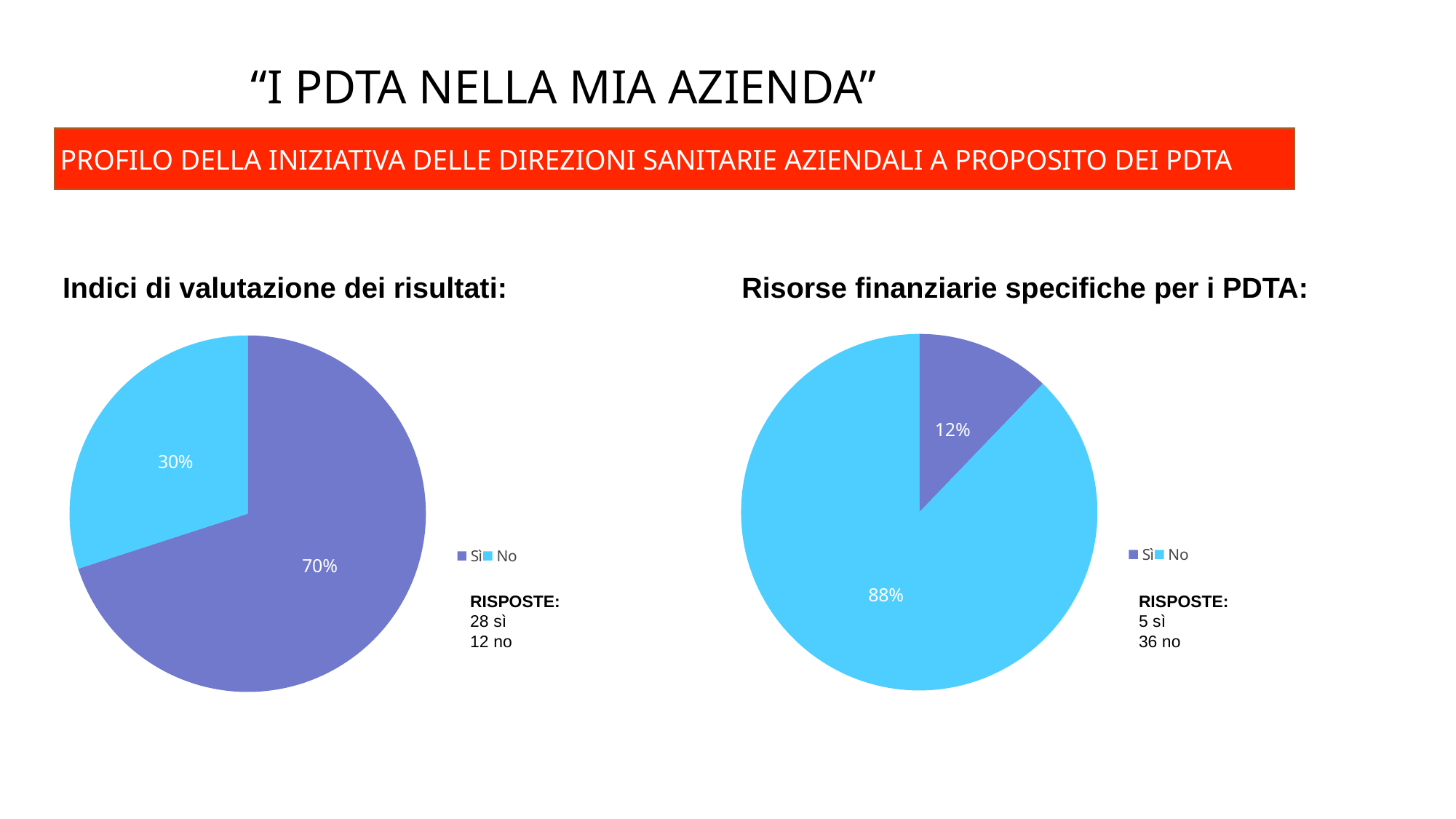
In the 'Risorse finanziarie specifiche per i PDTA' chart, what is the difference in percentage points between the 'No' and 'Sì' slices? 76 In the 'Risorse finanziarie specifiche per i PDTA' chart, what share of the pie is 'No'? 88% In the 'Risorse finanziarie specifiche per i PDTA' chart, which is larger, 'Sì' or 'No'? No What kind of chart is the 'Indici di valutazione dei risultati' chart? Pie chart In the 'Indici di valutazione dei risultati' chart, which slice is the largest? Sì In the 'Indici di valutazione dei risultati' chart, what is the difference in percentage points between the 'Sì' and 'No' slices? 40 In the 'Risorse finanziarie specifiche per i PDTA' chart, what share of the pie is 'Sì'? 12% What entries does the legend of the 'Indici di valutazione dei risultati' chart list? Sì, No In the 'Indici di valutazione dei risultati' chart, what share of the pie is 'Sì'? 70% How many slices does the 'Risorse finanziarie specifiche per i PDTA' pie chart have? 2 In the 'Risorse finanziarie specifiche per i PDTA' chart, which slice is the smallest? Sì